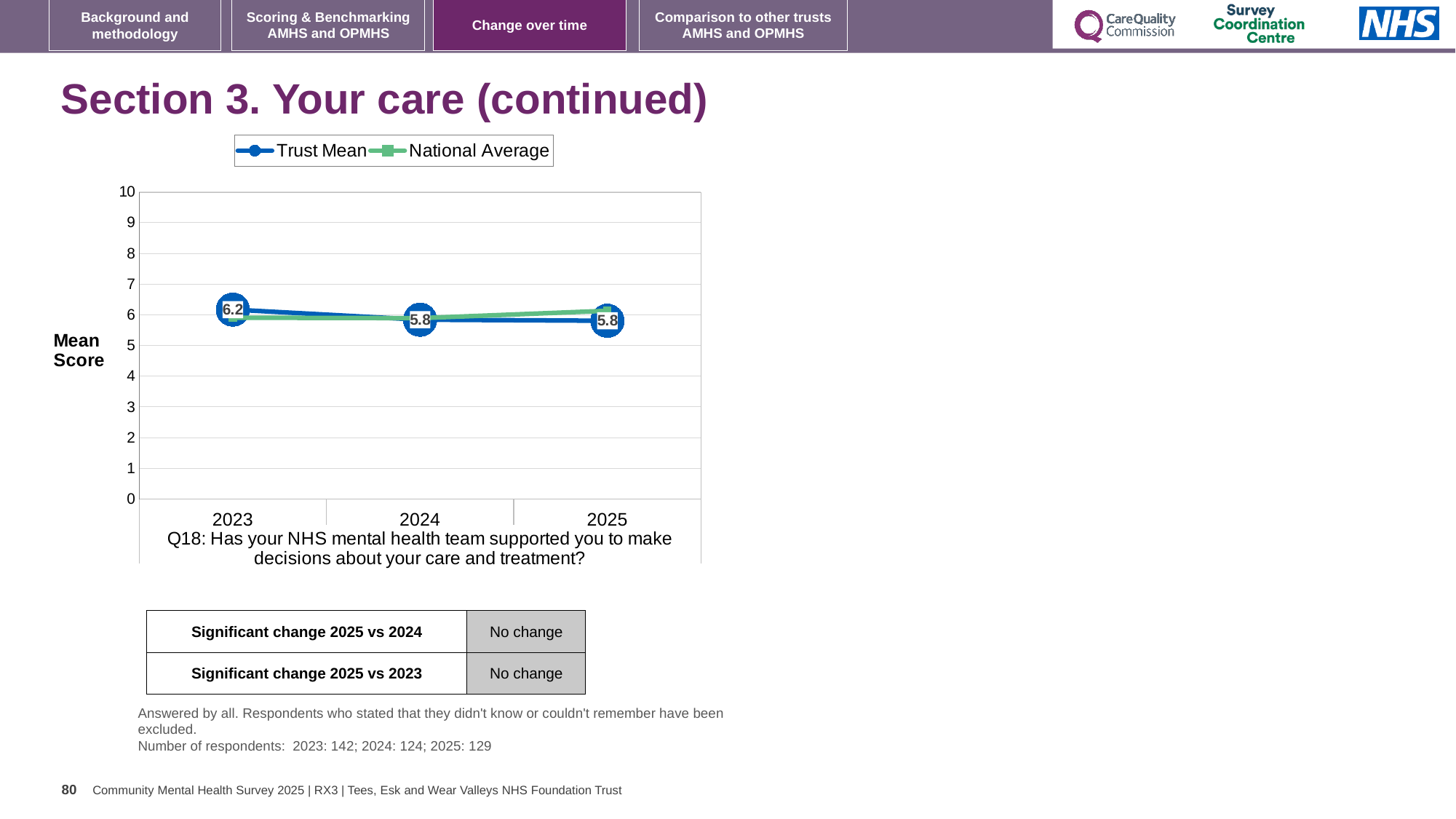
What is the difference between the Trust Mean score in 2023 and in 2024? 0.4 What is the Trust Mean score for 2024? 5.8 What kind of chart is shown on the slide? Line chart What is the Trust Mean score for 2023? 6.2 Does the Trust Mean score rise or fall from 2023 to 2025? Fall How many years are shown on the x axis of the chart? 3 What is the Trust Mean score for 2025? 5.8 In which year is the Trust Mean score highest? 2023 Is the National Average value for 2024 greater or less than 7? less How many series does the chart legend list? 2 Is the National Average value for 2025 greater or less than 5? greater Is the Trust Mean score for 2023 greater or less than 6? greater